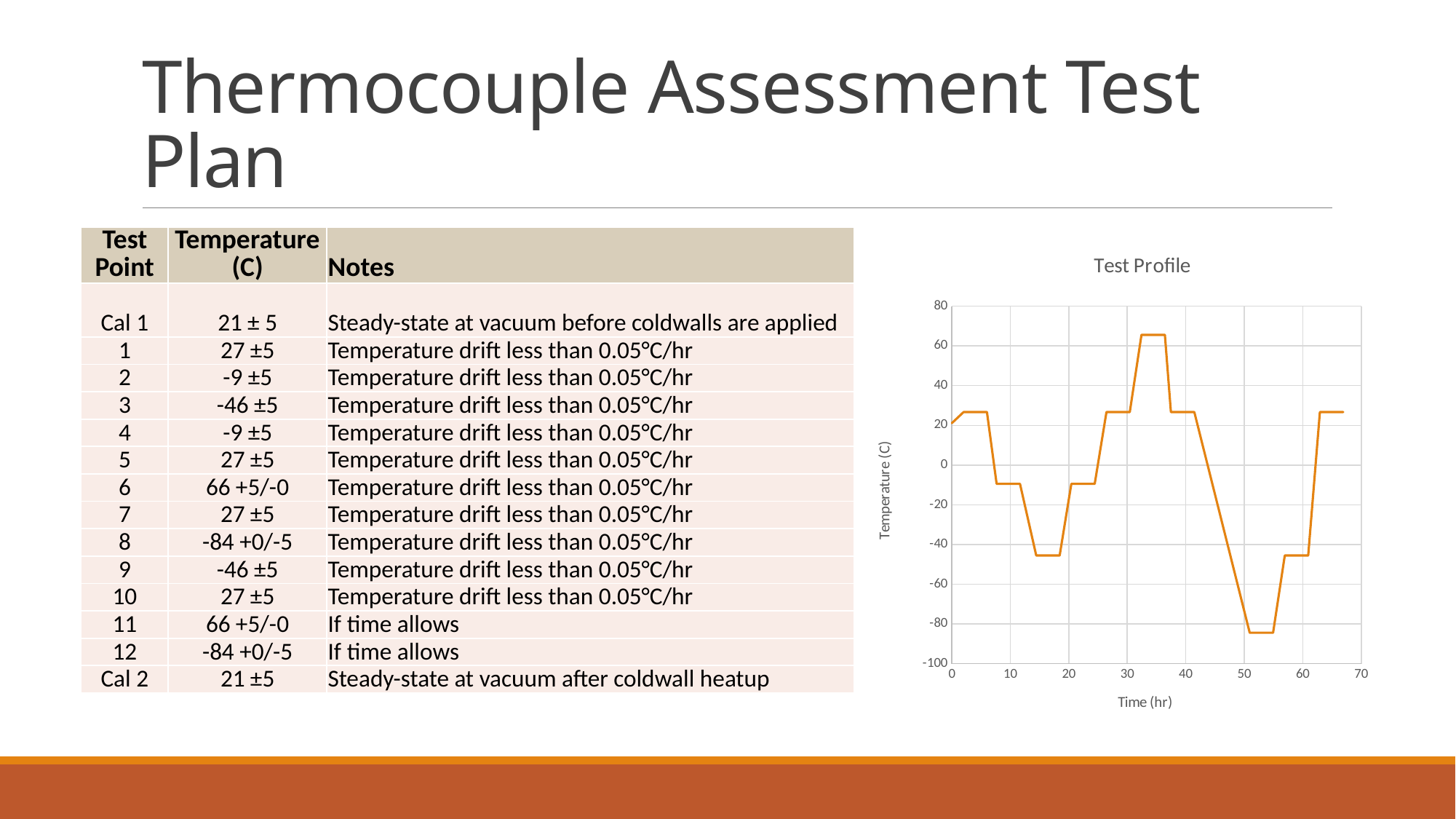
What is the label of the vertical axis of the Test Profile chart? Temperature (C) What is the title of the chart on the slide? Test Profile In the Test Profile chart, does the temperature rise or fall between 30 hr and 33 hr? rise In the Test Profile chart, does the temperature rise or fall between 55 hr and 58 hr? rise In the Test Profile chart, is the temperature at 65 hr greater or less than 0? greater In the Test Profile chart, is the temperature at 17 hr greater or less than -40? less What kind of chart is the Test Profile chart? line chart In the Test Profile chart, is the temperature at 35 hr greater or less than 40? greater In the Test Profile chart, does the temperature rise or fall between 40 hr and 50 hr? fall